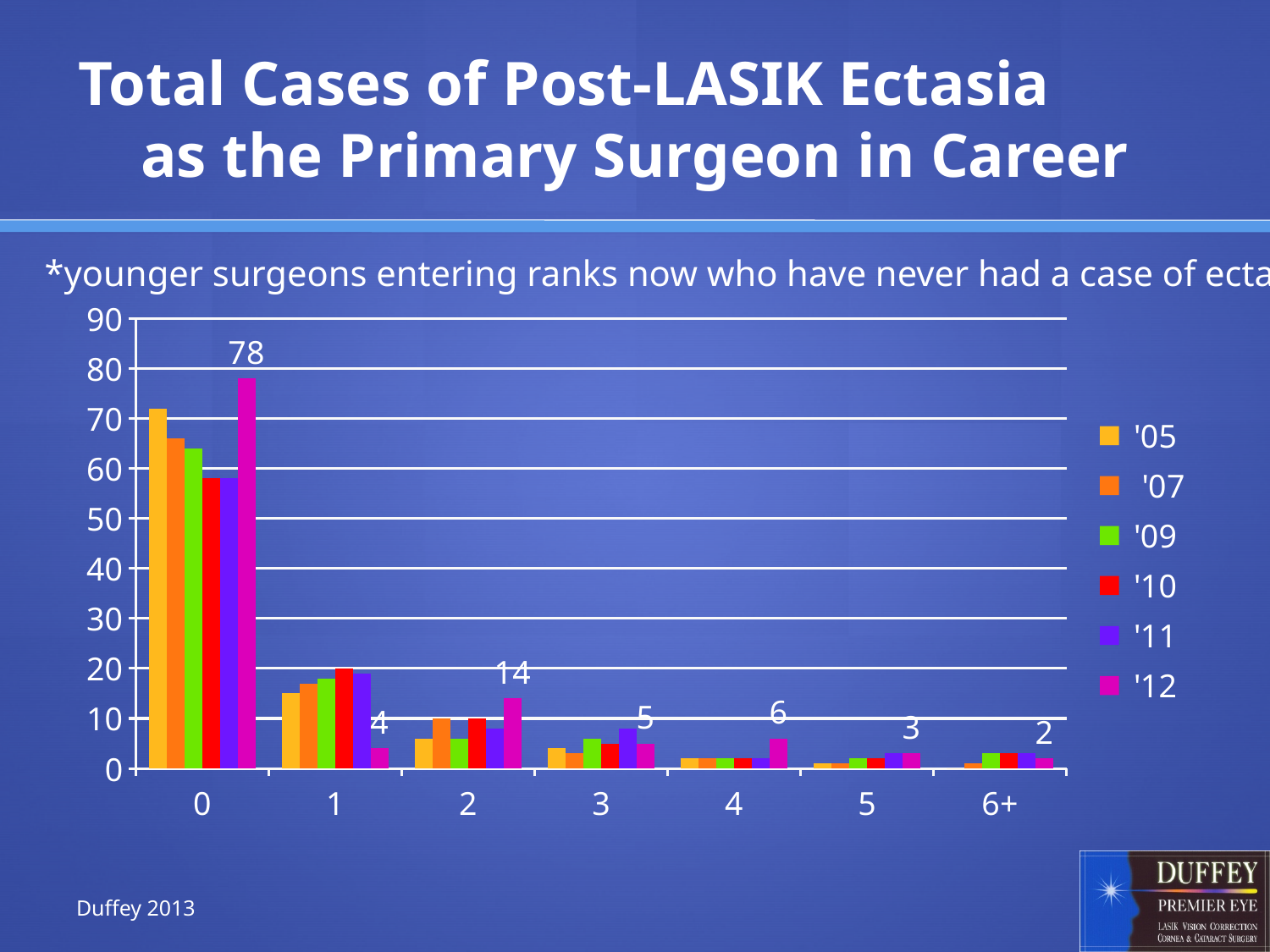
For the '12 series, which category has the highest value? 0 For the '12 series, which category has the lowest value? 6+ How many categories are shown on the x axis? 7 Is the value of the '05 series for category 0 greater or less than 60? greater What kind of chart is shown on the slide? bar chart What is the difference between the '12 values for category 0 and category 2? 64 Which is larger for the '12 series: the value for category 1 or category 2? category 2 What is the value of the '12 series for category 0? 78 What is the value of the '12 series for category 4? 6 What is the value of the '12 series for category 2? 14 How many series does the legend list? 6 What is the value of the '12 series for category 6+? 2